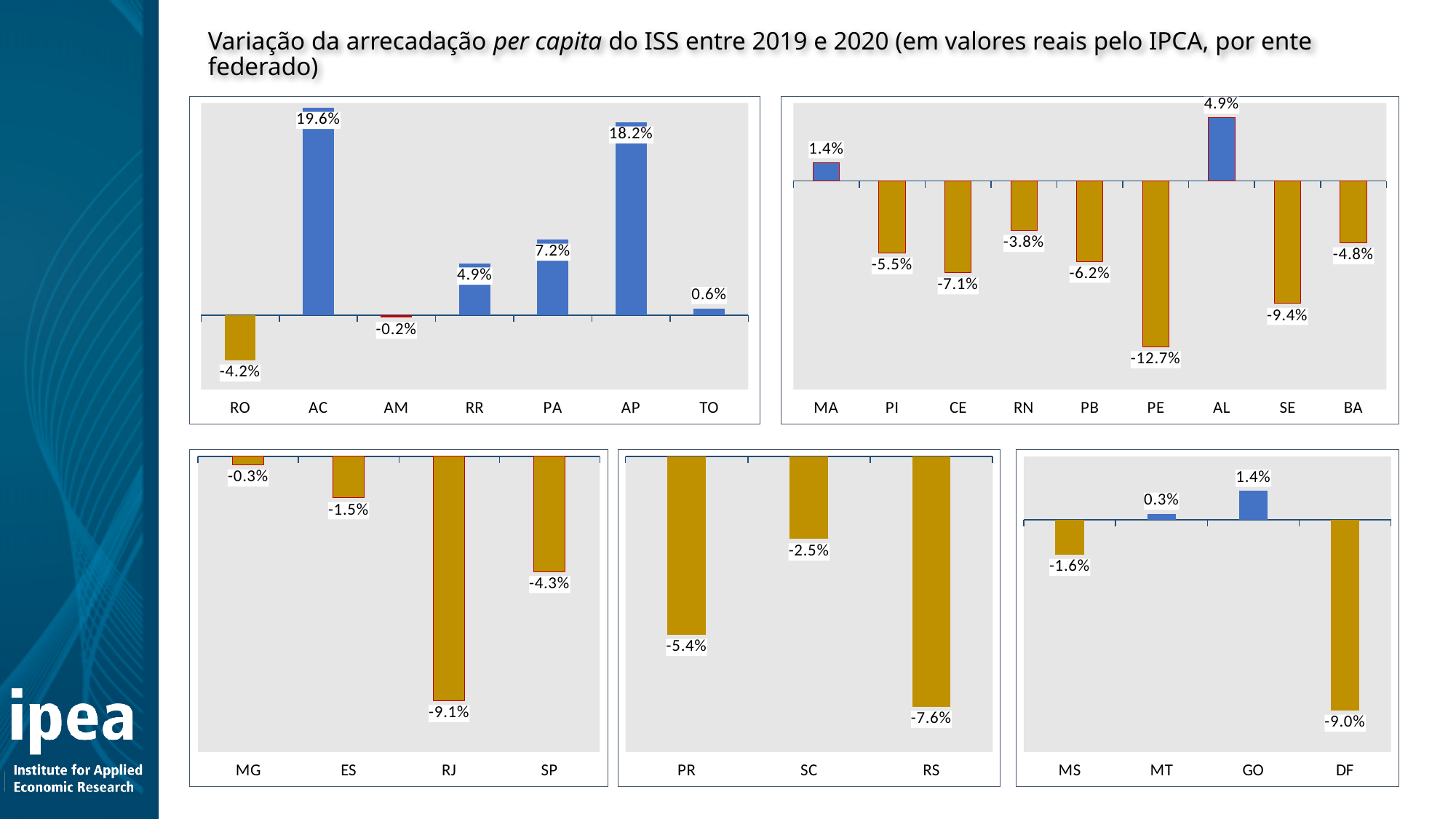
In the top-left chart, what is the difference between the values for AC and AP? 1.4 percentage points In the bottom-middle chart, how many categories are shown? 3 In the bottom-right chart, which category has the highest value? GO In the bottom-right chart, what is the value for DF? -9.0% In the top-right chart, how many categories are shown? 9 In the top-left chart, what is the value for AC? 19.6% In the top-right chart, which category has the lowest value? PE What kind of chart is the top-right chart? Bar chart In the top-right chart, what is the value for SE? -9.4% In the bottom-left chart, what is the difference between the values for RJ and SP? 4.8 percentage points In the top-left chart, which is larger, the value for RR or the value for PA? PA In the bottom-middle chart, what is the value for PR? -5.4%